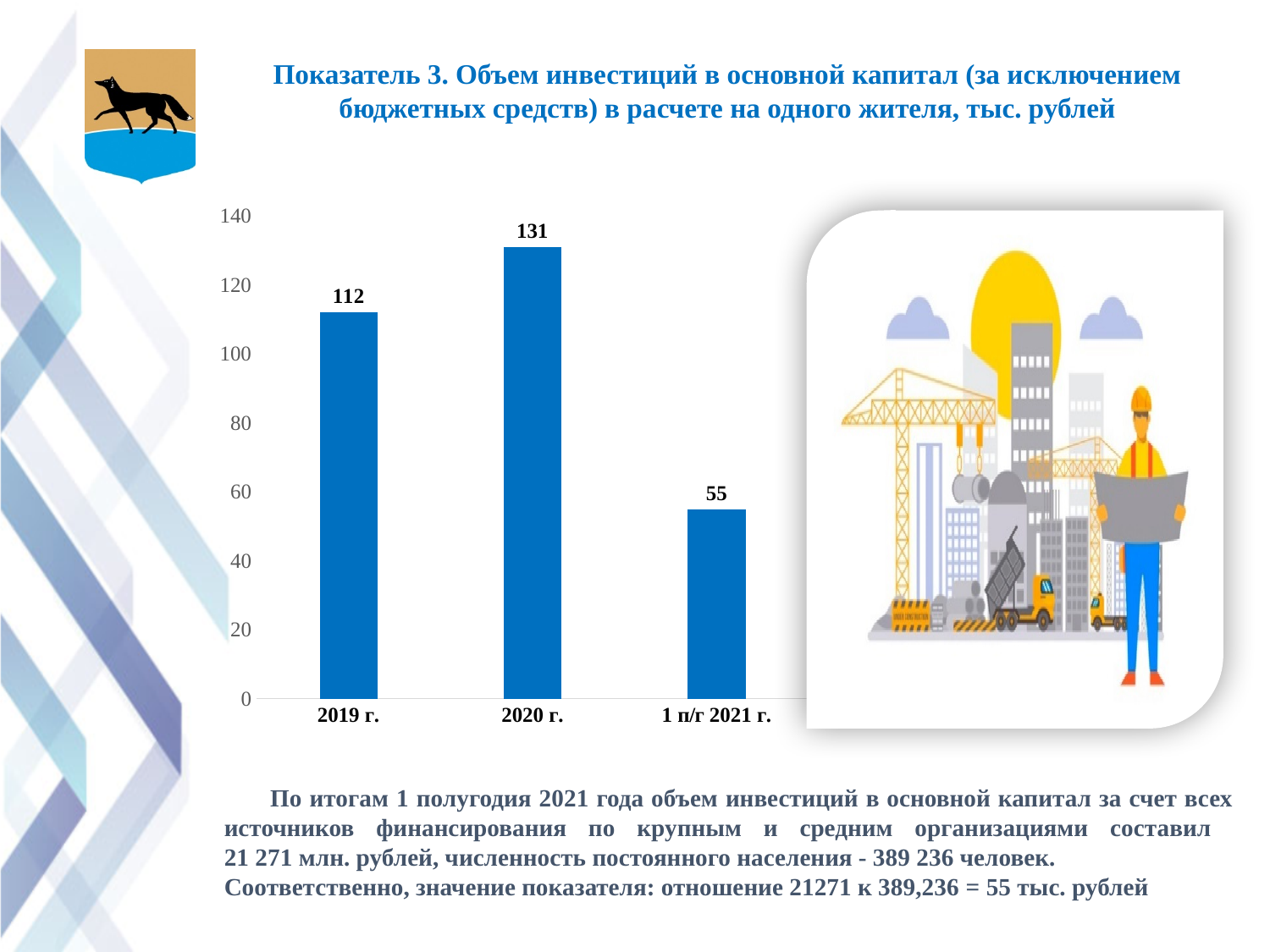
What is the difference between the values for 2020 г. and 1 п/г 2021 г.? 76 What is the value for 2019 г.? 112 What is the value for 1 п/г 2021 г.? 55 What is the value for 2020 г.? 131 What kind of chart is shown on the slide? bar chart What is the difference between the values for 2020 г. and 2019 г.? 19 Which category has the lowest value? 1 п/г 2021 г. What is the maximum value shown on the vertical axis? 140 Which category has the highest value? 2020 г. Which is larger, the value for 2019 г. or the value for 2020 г.? 2020 г. Is the value for 2019 г. greater or less than 100? greater How many categories are shown on the x axis? 3